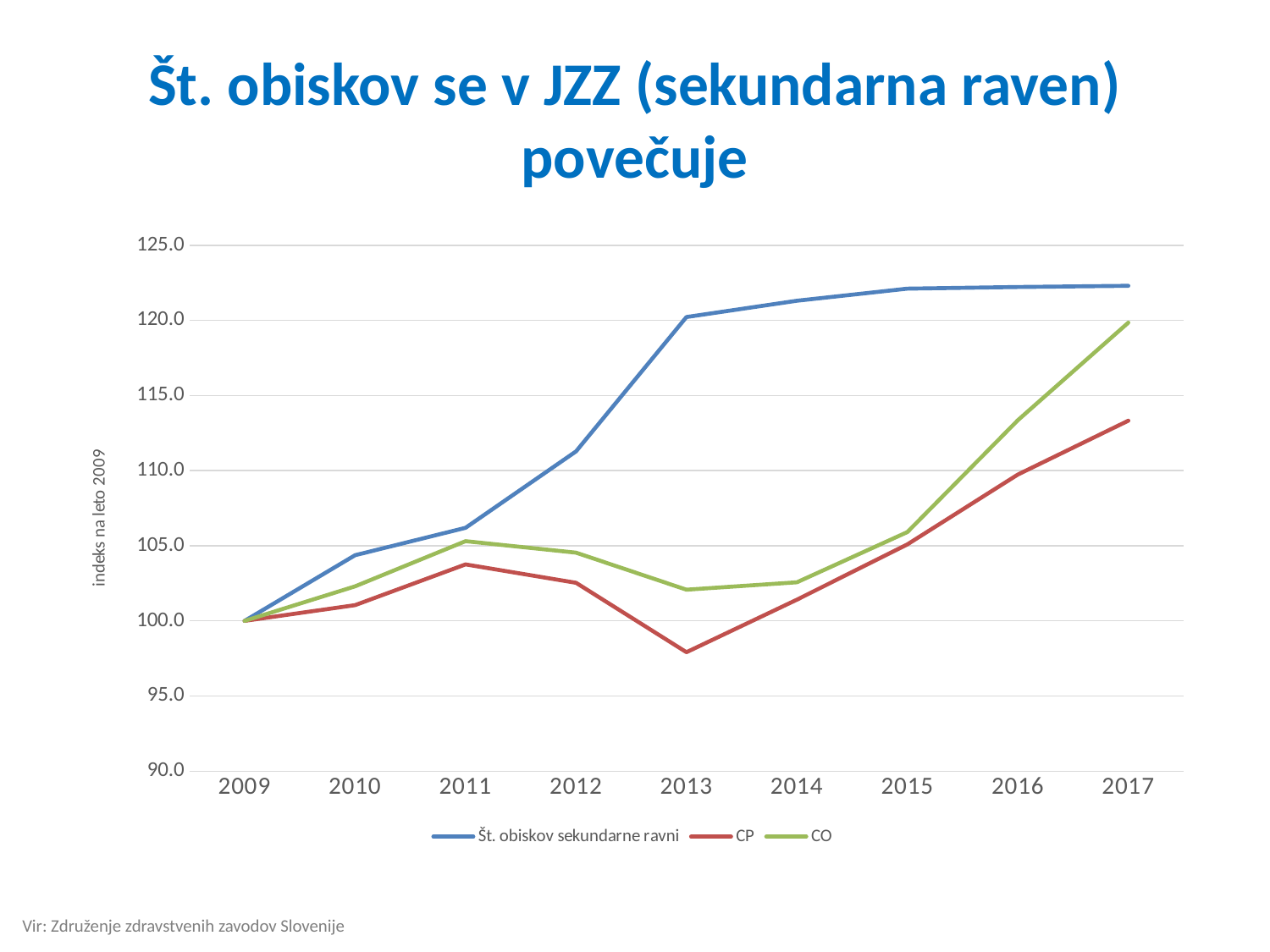
Is the value for Št. obiskov sekundarne ravni in 2017 greater or less than 120.0? greater What is the value of the CP series in 2009? 100.0 What is the label on the y axis? indeks na leto 2009 Does the Št. obiskov sekundarne ravni series generally rise or fall from 2009 to 2017? rise How many years are shown on the x axis? 9 In which year does the CP series reach its lowest value? 2013 How many series does the legend list? 3 What kind of chart is shown on the slide? line chart Is the value for CP in 2013 greater or less than 100.0? less In which year does the CO series reach its highest value? 2017 Is the value for CO in 2016 greater or less than 110.0? greater In 2017, which series has the larger value, CO or CP? CO